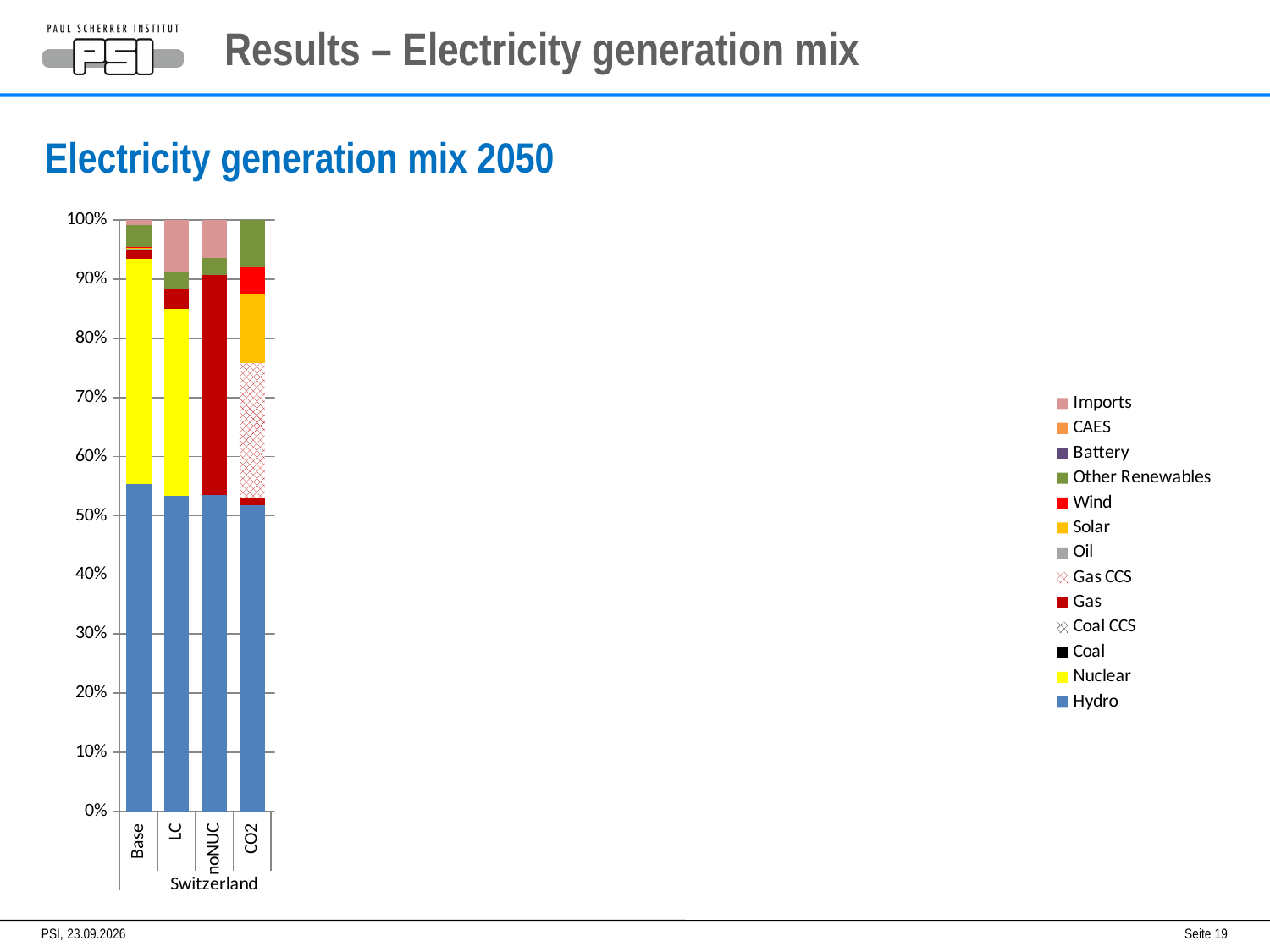
What kind of chart is shown on the slide? Stacked bar chart How many series does the legend list? 13 Which scenario has no Nuclear share in its bar? noNUC and CO2 Which has the larger Imports share, Base or LC? LC Which country label appears under the scenario bars? Switzerland Which scenario has the largest Gas share? noNUC Which scenario is the only one that includes Gas CCS? CO2 Which scenario has the largest Nuclear share? Base Is the Hydro share in the Base scenario greater or less than 50%? greater Is the Hydro share in the CO2 scenario greater or less than 60%? less How many scenario bars are plotted in the chart? 4 What is the total of the stacked bar for the Base scenario? 100%